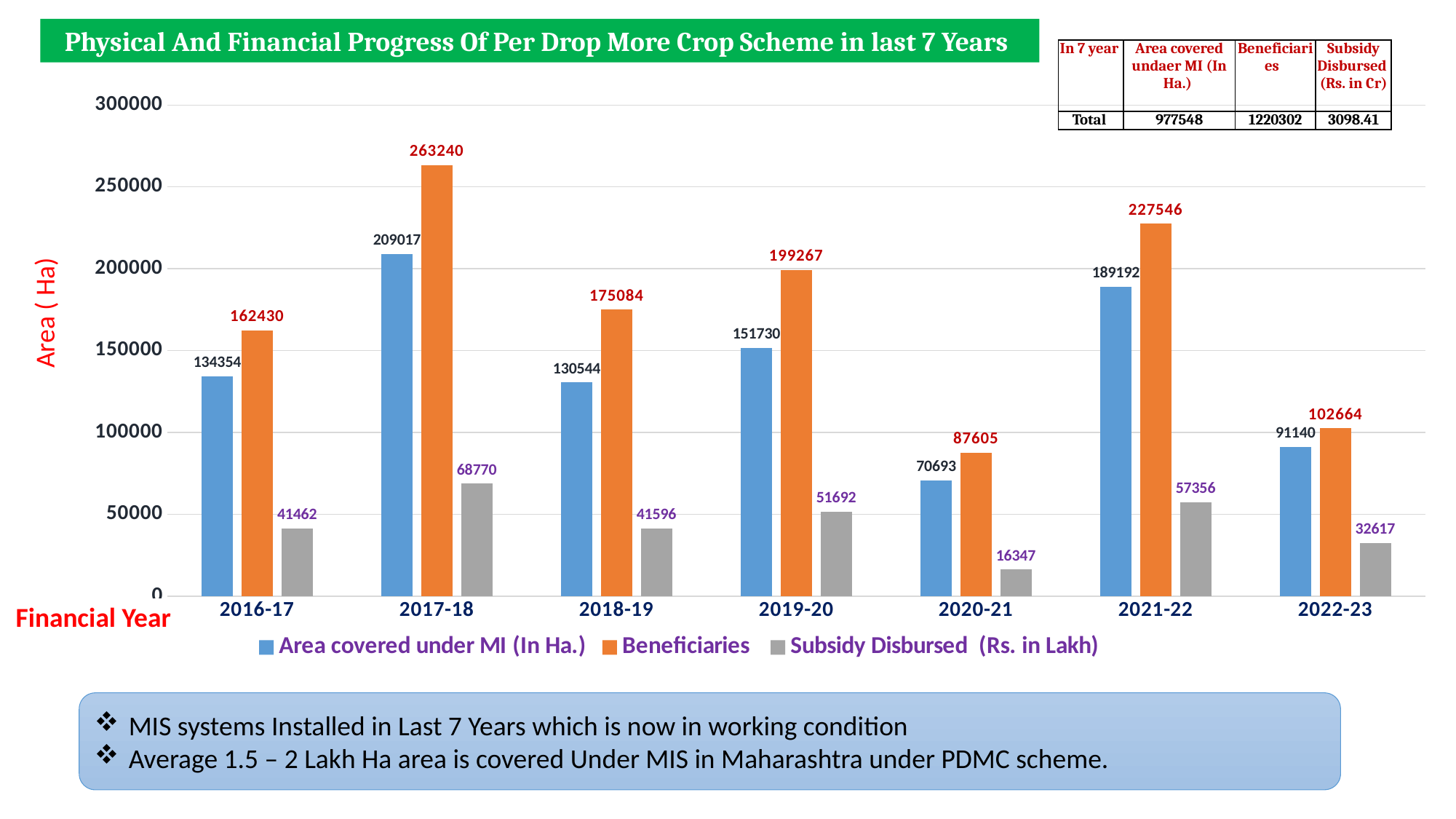
How many financial years are shown on the x axis? 7 How many series does the legend list? 3 What is the value for Beneficiaries in 2017-18? 263240 What is the value for Area covered under MI (In Ha.) in 2019-20? 151730 Which financial year has the highest value for Beneficiaries? 2017-18 What is the difference between Subsidy Disbursed (Rs. in Lakh) in 2017-18 and in 2016-17? 27308 What kind of chart is shown on the slide? Bar chart Which is larger: Area covered under MI (In Ha.) in 2021-22 or in 2019-20? 2021-22 What is the difference between Beneficiaries and Area covered under MI (In Ha.) in 2017-18? 54223 Is the value for Beneficiaries in 2022-23 greater or less than 100000? greater What is the value for Subsidy Disbursed (Rs. in Lakh) in 2020-21? 16347 Which financial year has the lowest value for Area covered under MI (In Ha.)? 2020-21